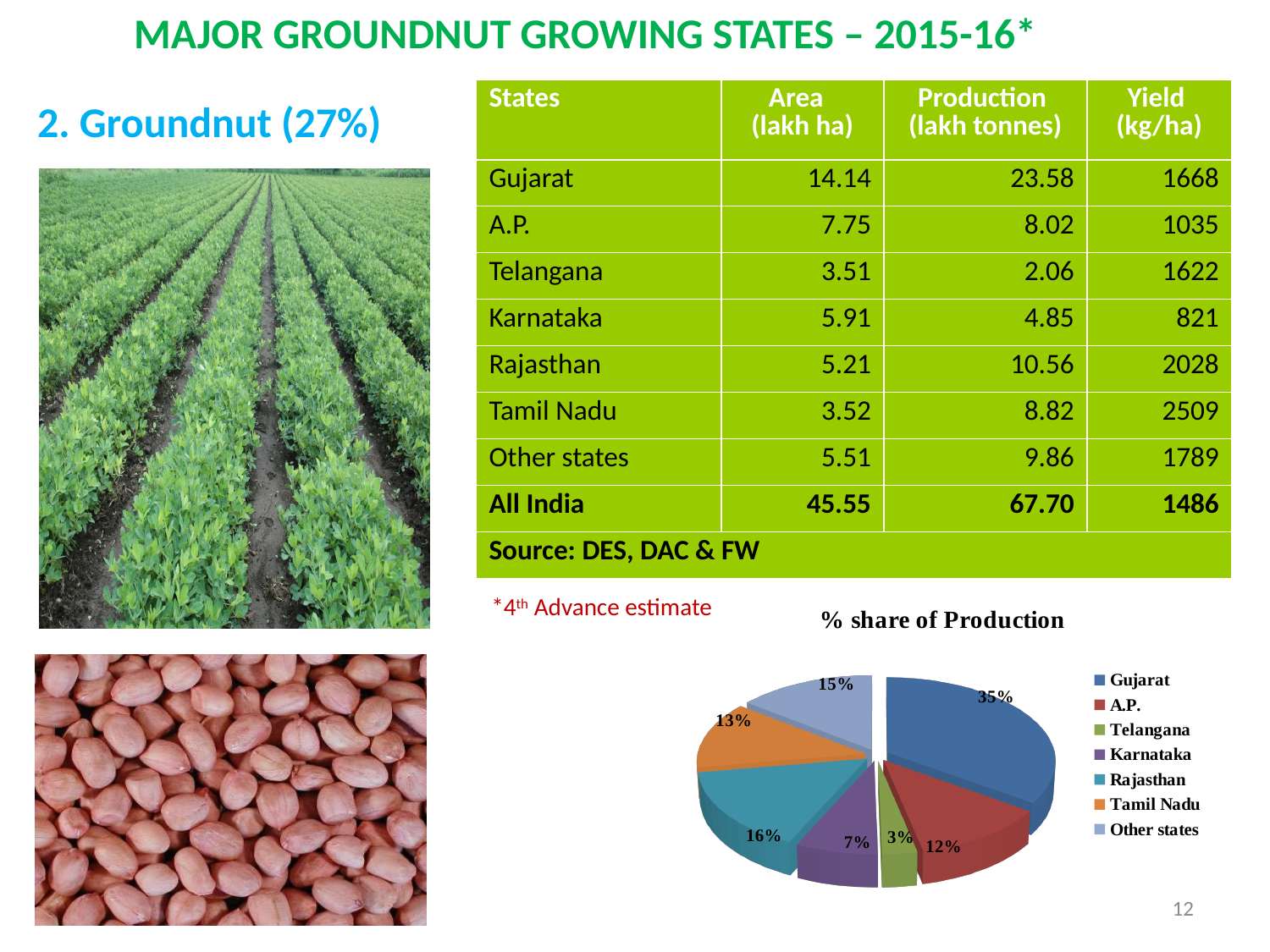
Which has a larger share of production in the pie chart, Rajasthan or Karnataka? Rajasthan What share of production does Tamil Nadu have in the pie chart? 13% What is the title of the pie chart? % share of Production Which state has the largest share of production in the pie chart? Gujarat What kind of chart is shown on the slide? pie chart Which state has the smallest share of production in the pie chart? Telangana What share of production does Rajasthan have in the pie chart? 16% How many entries does the pie chart legend list? 7 What share of production does Gujarat have in the pie chart? 35% What share of production does Telangana have in the pie chart? 3% What is the difference in production share between Gujarat and A.P. in the pie chart? 23% How many slices does the pie chart have? 7